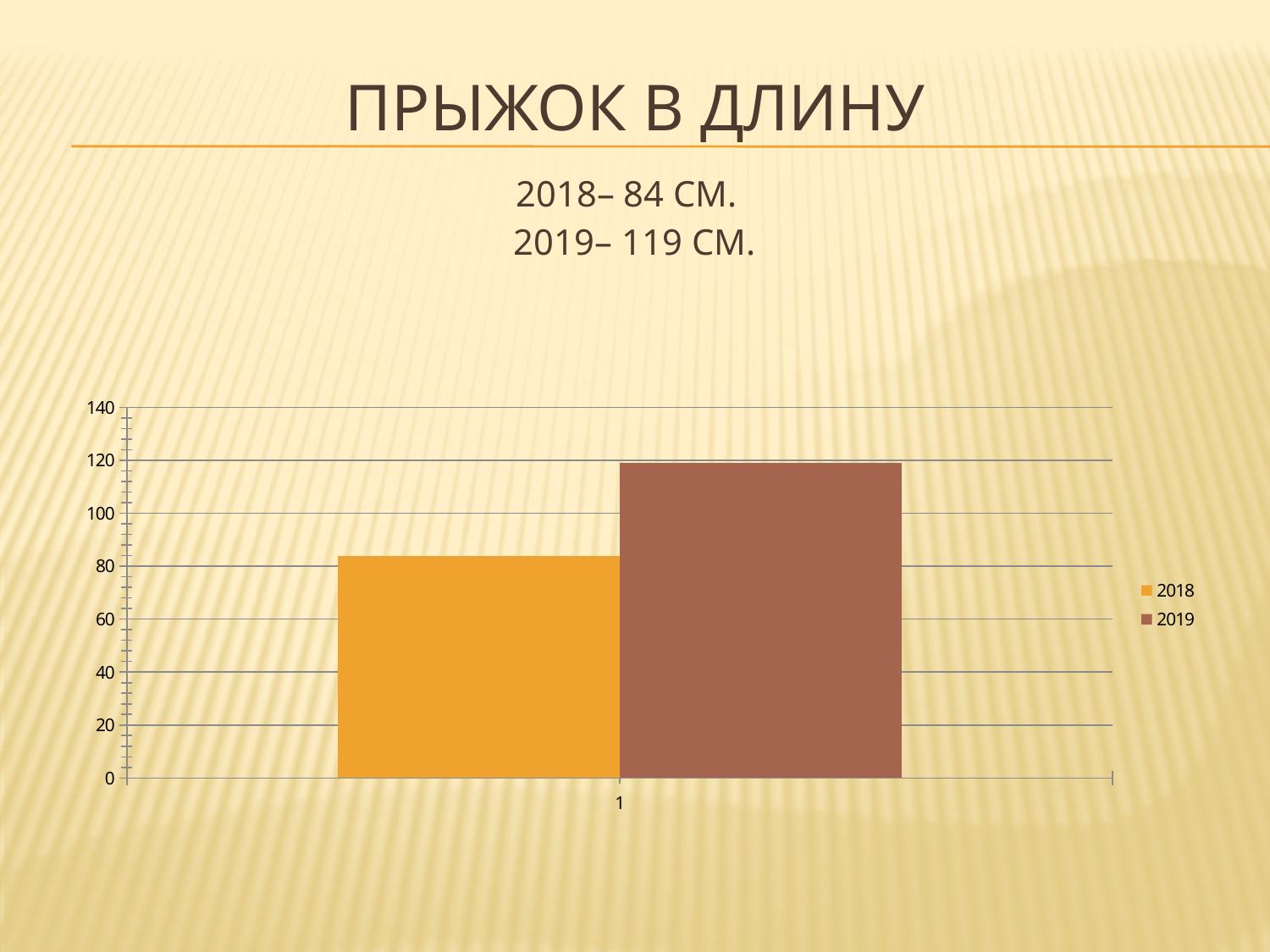
By how much does the 2019 value exceed the 2018 value? 35 What is the value for 2019 according to the slide? 119 СМ. How many categories are shown on the x axis of the chart? 1 Is the value for 2018 greater or less than 100? less What is the title of the slide containing the chart? ПРЫЖОК В ДЛИНУ Which series has the higher bar, 2018 or 2019? 2019 Which series has the highest value in the chart? 2019 What type of chart is shown on the slide? bar chart Is the value for 2019 greater or less than 100? greater What is the value for 2018 according to the slide? 84 СМ. Which series has the lowest value in the chart? 2018 How many series does the chart legend list? 2